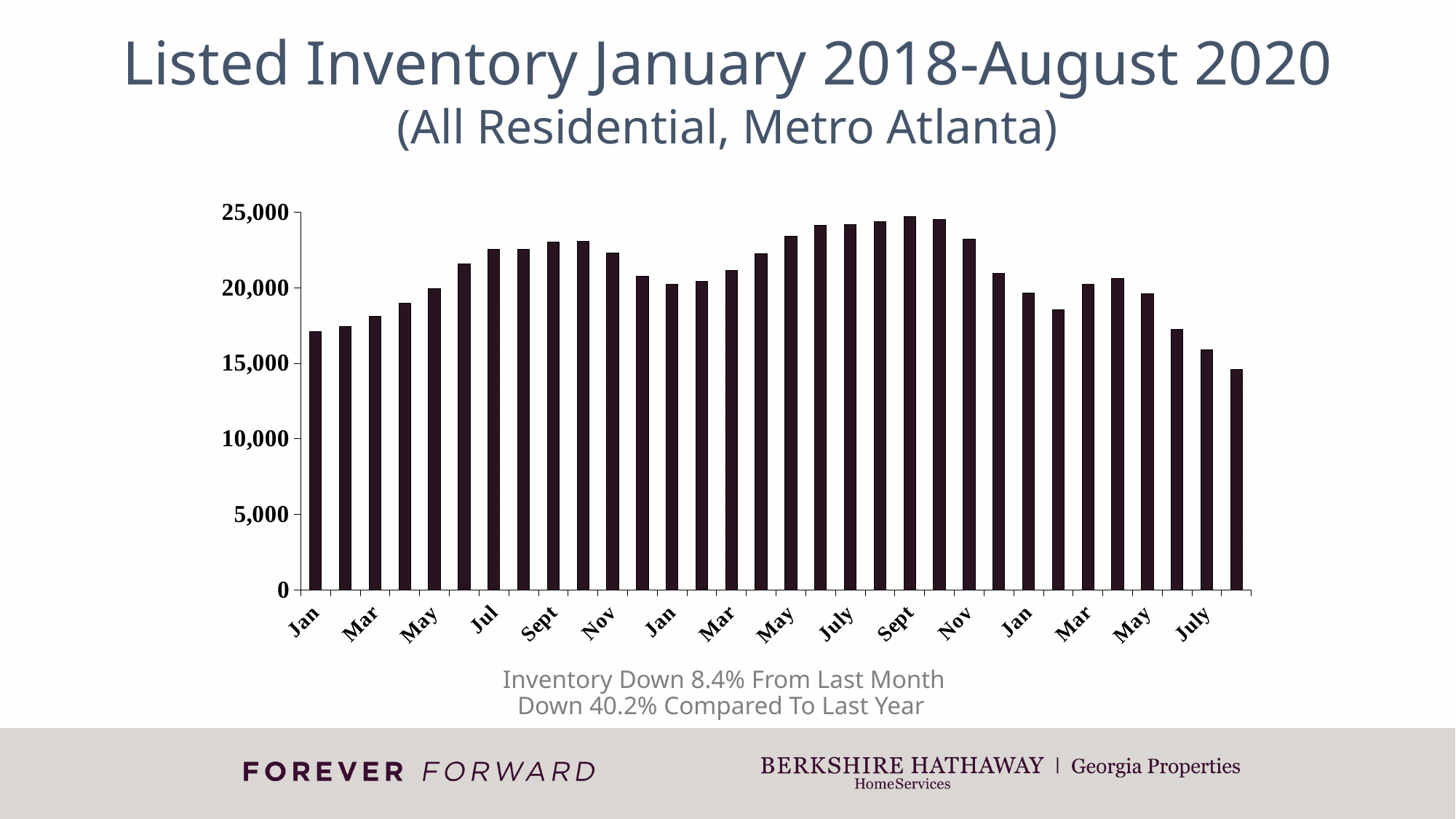
What kind of chart is shown on the slide? Bar chart Do the listed inventory values rise or fall from September 2019 through August 2020? fall Is the listed inventory for July 2020 greater or less than 15,000? greater Is the listed inventory for September 2019 greater or less than 20,000? greater How many monthly bars are plotted in the chart? 32 Is the listed inventory for January 2018 (the first bar) greater or less than 20,000? less Which is larger, the listed inventory in January 2018 or in January 2019? January 2019 Which month has the lowest listed inventory in the chart? August 2020 (the last bar) According to the note below the chart, by what percentage is inventory down compared to last year? 40.2% What is the title of the chart on the slide? Listed Inventory January 2018-August 2020 (All Residential, Metro Atlanta)